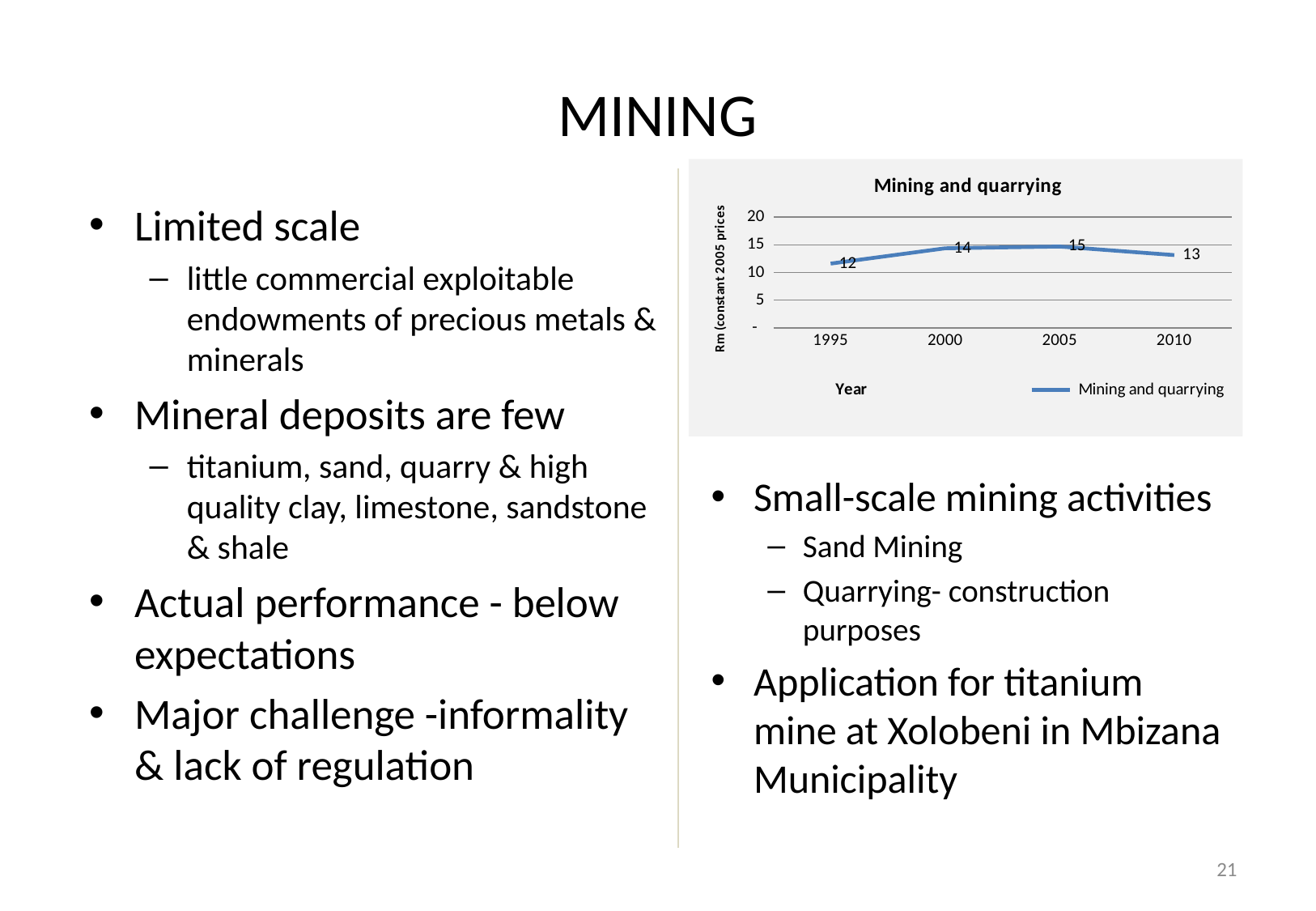
What kind of chart is the Mining and quarrying chart? line chart How many series does the legend of the Mining and quarrying chart list? 1 What is the title of the chart on the slide? Mining and quarrying Which year has the lowest value for Mining and quarrying? 1995 Which is larger, the Mining and quarrying value for 2000 or for 2010? 2000 What is the value for Mining and quarrying in 2000? 14 What is the value for Mining and quarrying in 2010? 13 What is the value for Mining and quarrying in 2005? 15 Which year has the highest value for Mining and quarrying? 2005 How many years are plotted on the Mining and quarrying chart? 4 What is the value for Mining and quarrying in 1995? 12 What is the difference between the Mining and quarrying values for 2005 and 1995? 3